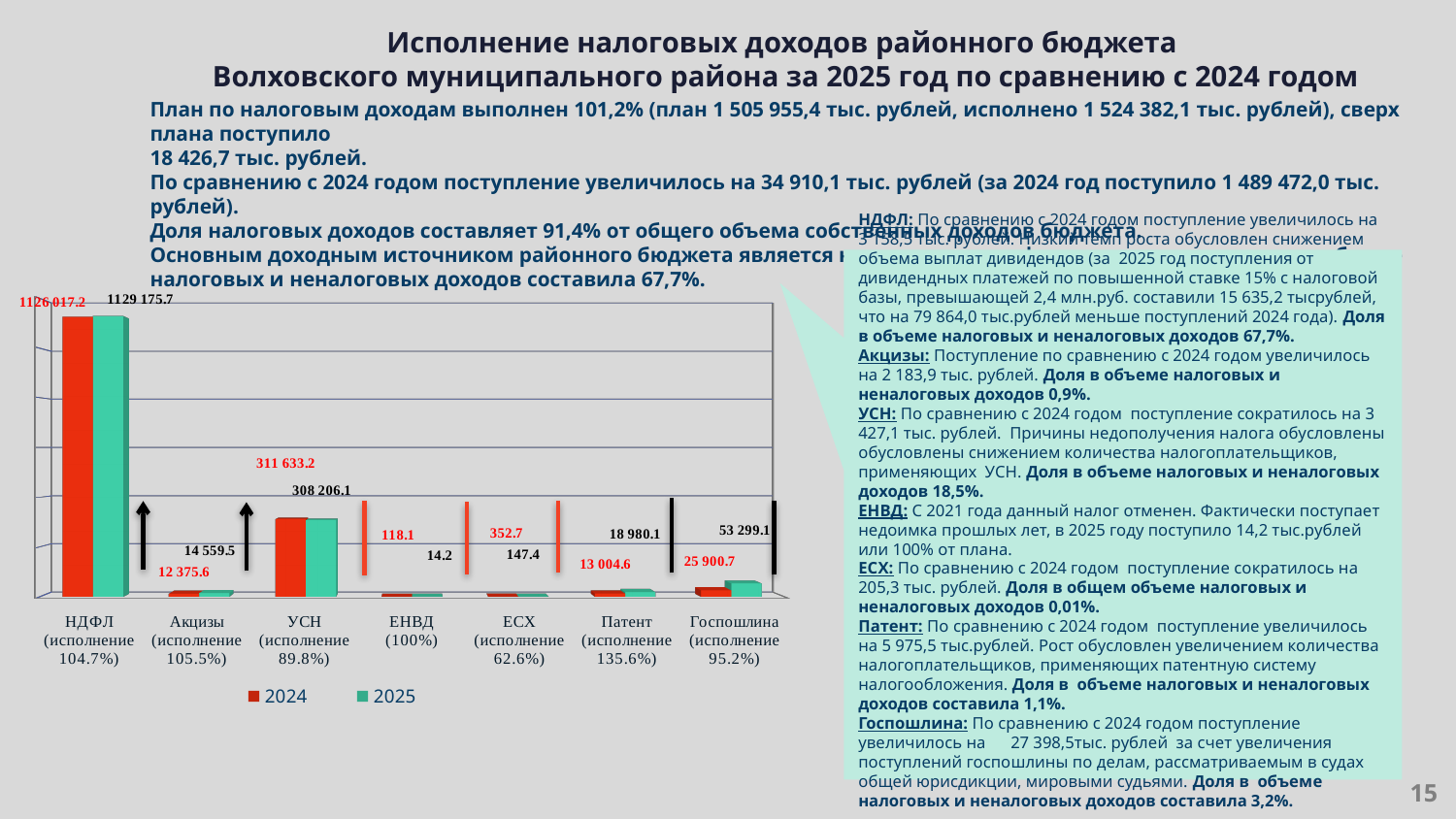
What is the 2025 value for ЕНВД? 14.2 What is the 2025 value for Госпошлина? 53 299.1 How many series does the chart legend list? 2 How many categories are shown on the x axis of the chart? 7 What are the two entries in the chart legend? 2024 and 2025 Which category has the highest 2025 value? НДФЛ What type of chart is shown on the slide? bar chart What is the difference between the 2025 and 2024 values for Госпошлина? 27 398.4 For Патент, which year has the larger value, 2024 or 2025? 2025 What is the 2025 value for ЕСХ? 147.4 What is the 2024 value for УСН? 311 633.2 Which category has the lowest 2025 value? ЕНВД